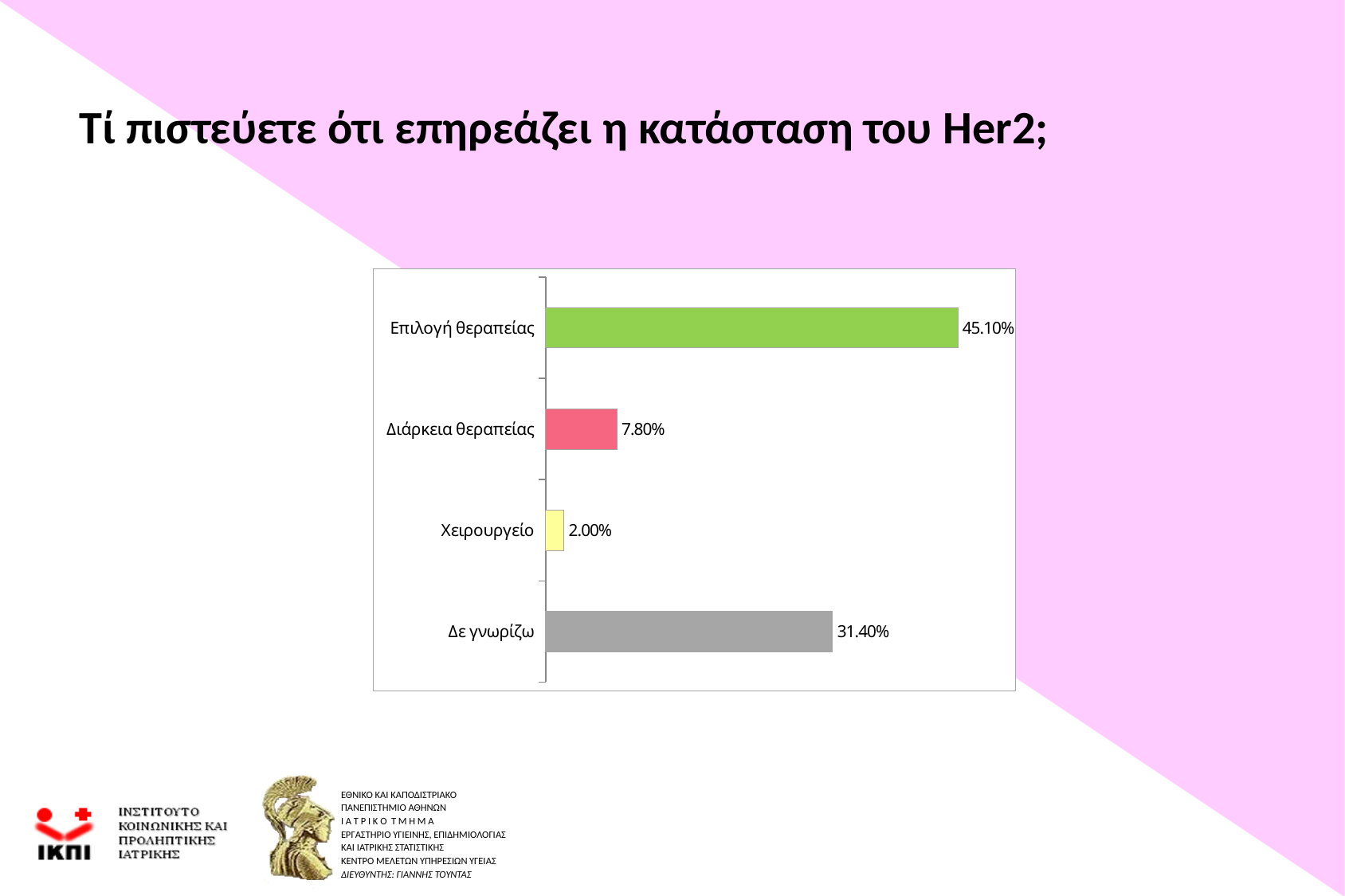
What is the difference between the values for Επιλογή θεραπείας and Δε γνωρίζω? 13.70% What colour is the bar for Επιλογή θεραπείας? Green What is the value for Επιλογή θεραπείας? 45.10% Which category has the lowest value? Χειρουργείο What is the value for Διάρκεια θεραπείας? 7.80% How many categories are shown in the chart? 4 What is the difference between the values for Διάρκεια θεραπείας and Χειρουργείο? 5.80% What is the value for Χειρουργείο? 2.00% What is the value for Δε γνωρίζω? 31.40% Which category has the highest value? Επιλογή θεραπείας What kind of chart is shown on the slide? Bar chart Which is larger, the value for Δε γνωρίζω or the value for Διάρκεια θεραπείας? Δε γνωρίζω